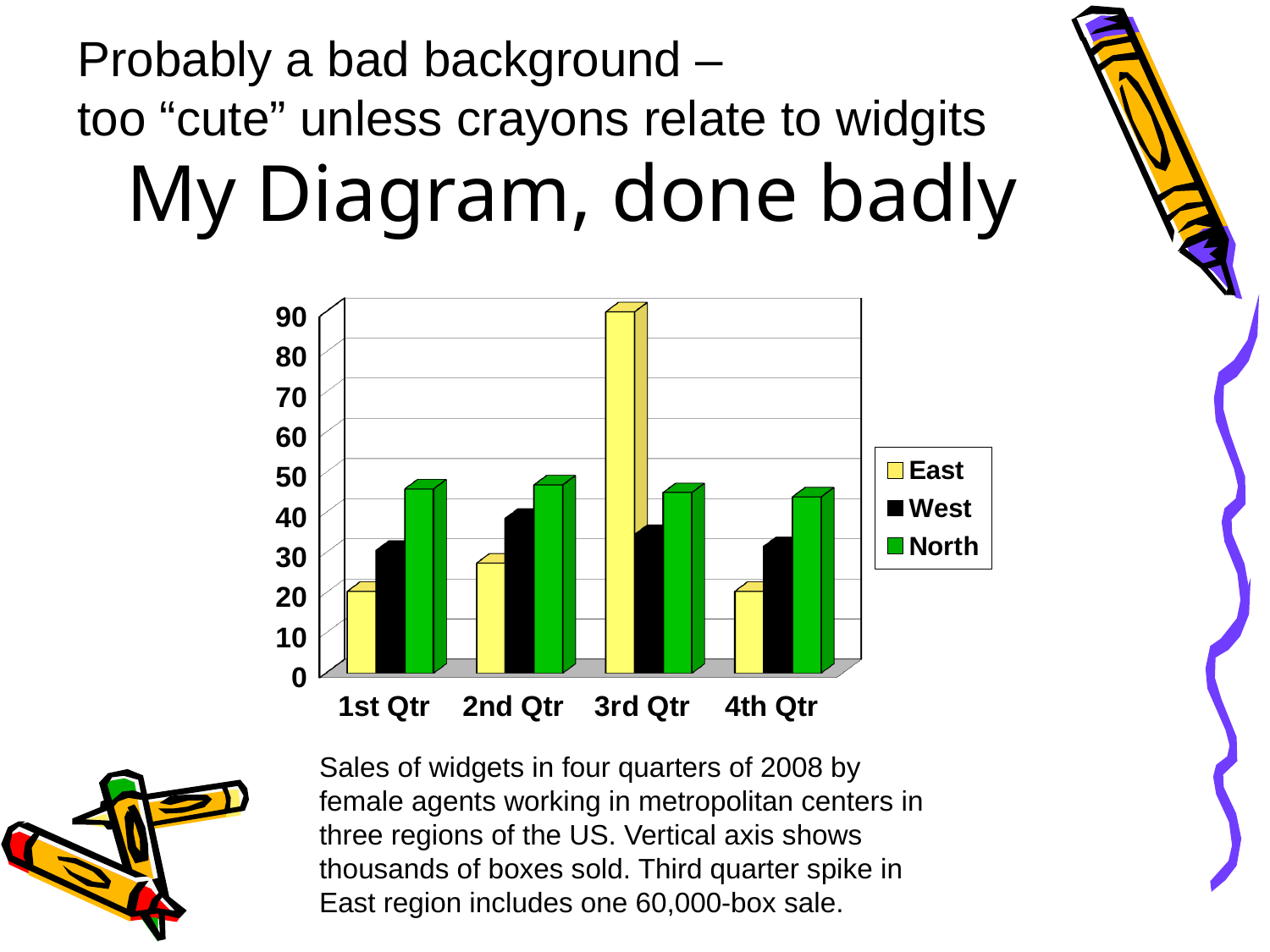
Is the value for East in 1st Qtr greater or less than 30? less How many series does the legend list? 3 In 1st Qtr, which is larger, West or North? North In 3rd Qtr, which is larger, East or North? East Is the value for East in 2nd Qtr greater or less than 40? less Is the value for East in 3rd Qtr greater or less than 80? greater What kind of chart is shown on the slide? bar chart Which series is shown in green in the legend? North In which quarter is the East series highest? 3rd Qtr How many quarters are shown on the x axis? 4